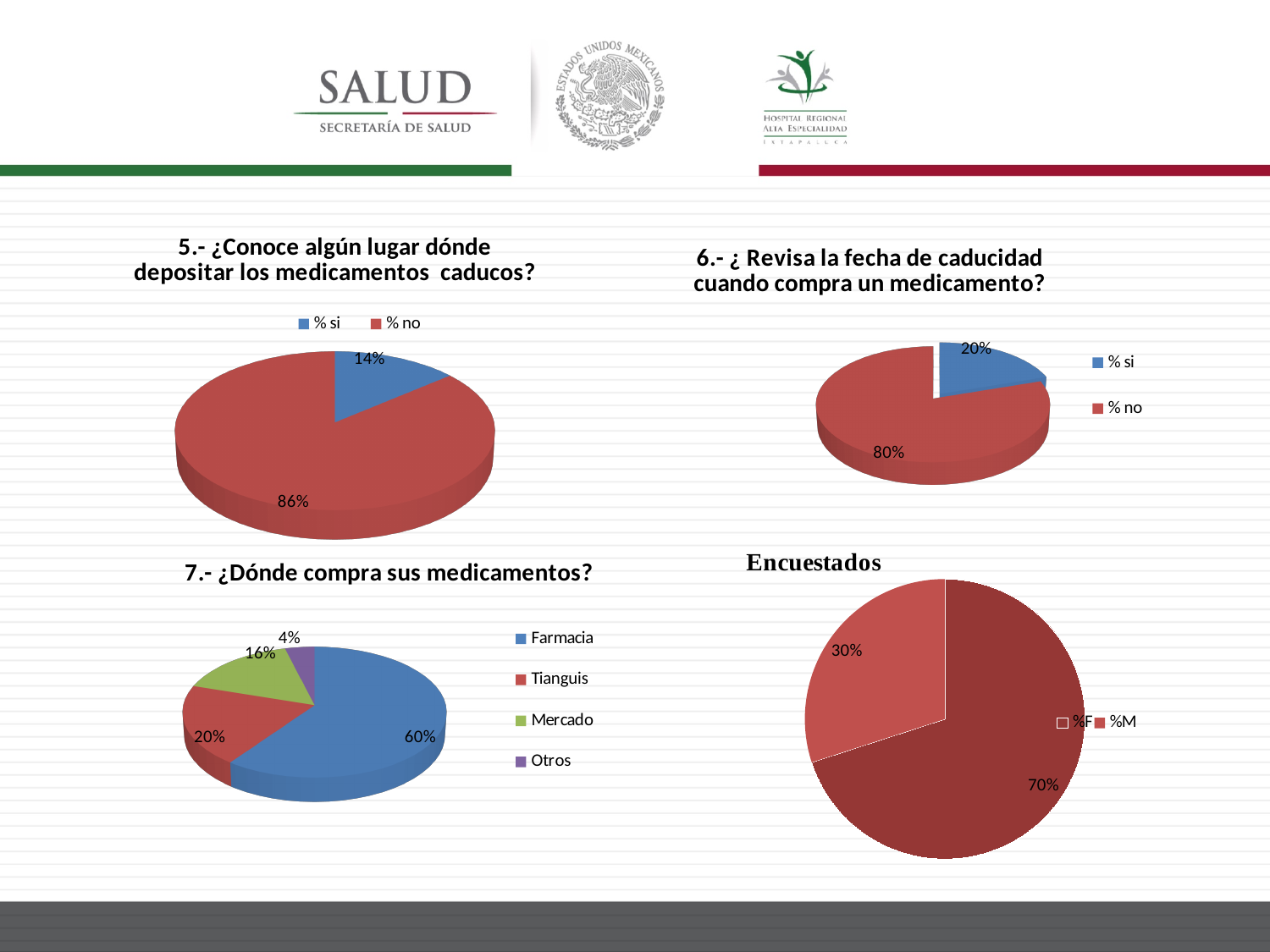
In the chart titled "Encuestados", what is the percentage of the largest slice? 70% In the chart titled "7.- ¿Dónde compra sus medicamentos?", how many categories does the legend list? 4 In the chart titled "6.- ¿ Revisa la fecha de caducidad cuando compra un medicamento?", what percentage is shown for "% si"? 20% In the chart titled "7.- ¿Dónde compra sus medicamentos?", what percentage is shown for Farmacia? 60% In the chart titled "6.- ¿ Revisa la fecha de caducidad cuando compra un medicamento?", what is the difference between the "% no" and "% si" shares? 60% In the chart titled "5.- ¿Conoce algún lugar dónde depositar los medicamentos caducos?", what percentage is shown for "% si"? 14% In the chart titled "5.- ¿Conoce algún lugar dónde depositar los medicamentos caducos?", what percentage is shown for "% no"? 86% How many charts are shown on the slide? 4 In the chart titled "7.- ¿Dónde compra sus medicamentos?", which category has the largest share? Farmacia What kind of chart is the chart titled "Encuestados"? Pie chart In the chart titled "7.- ¿Dónde compra sus medicamentos?", which category has the smallest share? Otros In the chart titled "7.- ¿Dónde compra sus medicamentos?", which is larger, Tianguis or Mercado? Tianguis